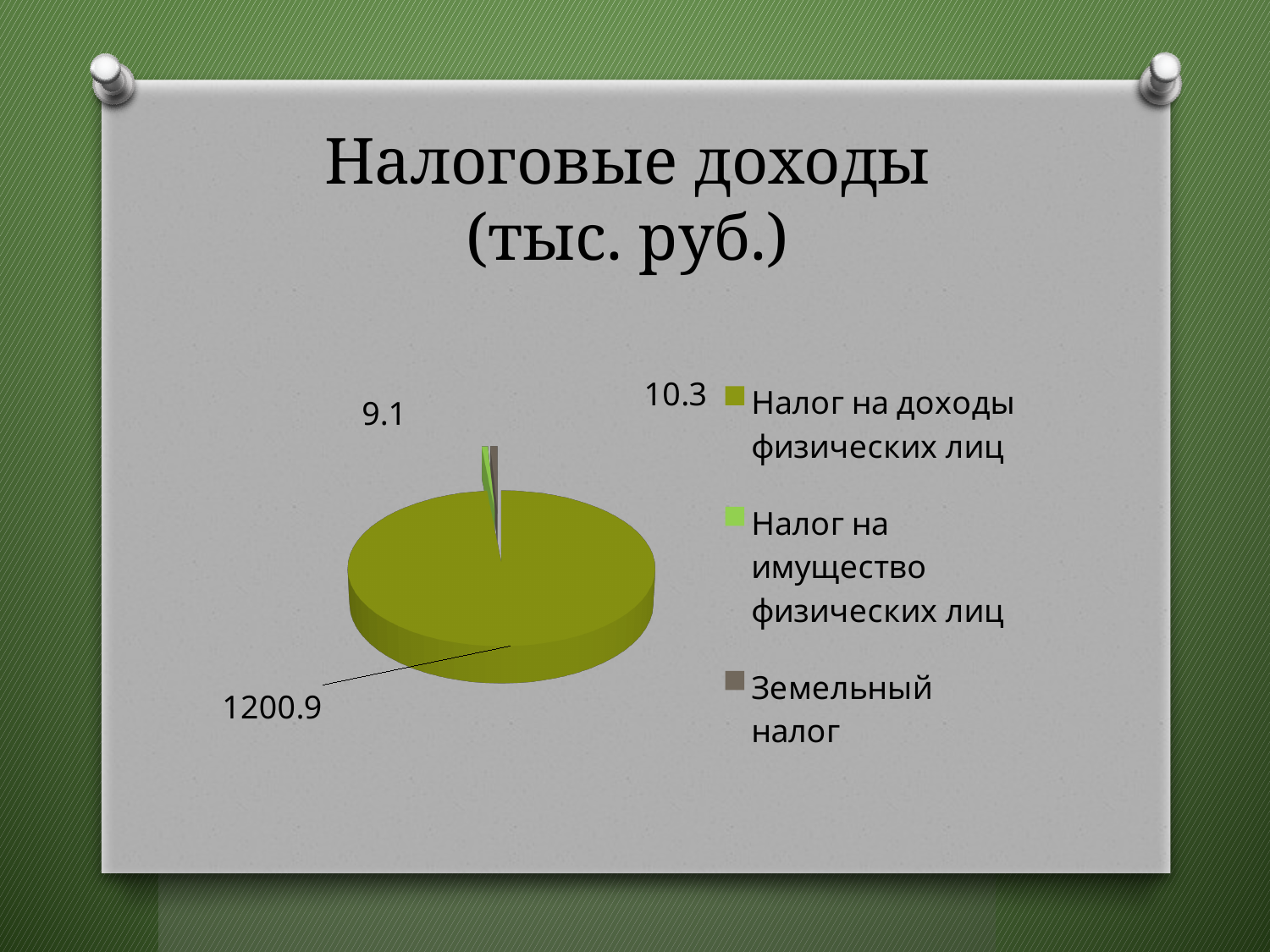
How many categories does the legend list? 3 What is the smallest value labelled on the chart? 9.1 Which category has the largest slice of the pie? Налог на доходы физических лиц Is the value for Налог на доходы физических лиц greater or less than 1000? greater What share of the pie does the slice labelled 1200.9 represent, to the nearest whole percent? 98% What is the value for Налог на доходы физических лиц? 1200.9 Which is larger, Налог на доходы физических лиц or Налог на имущество физических лиц? Налог на доходы физических лиц Which legend entry is listed last? Земельный налог What is the total of all three values shown on the chart? 1220.3 Which is larger, Налог на доходы физических лиц or Земельный налог? Налог на доходы физических лиц What is the title of the chart? Налоговые доходы (тыс. руб.) What kind of chart is shown on the slide? Pie chart